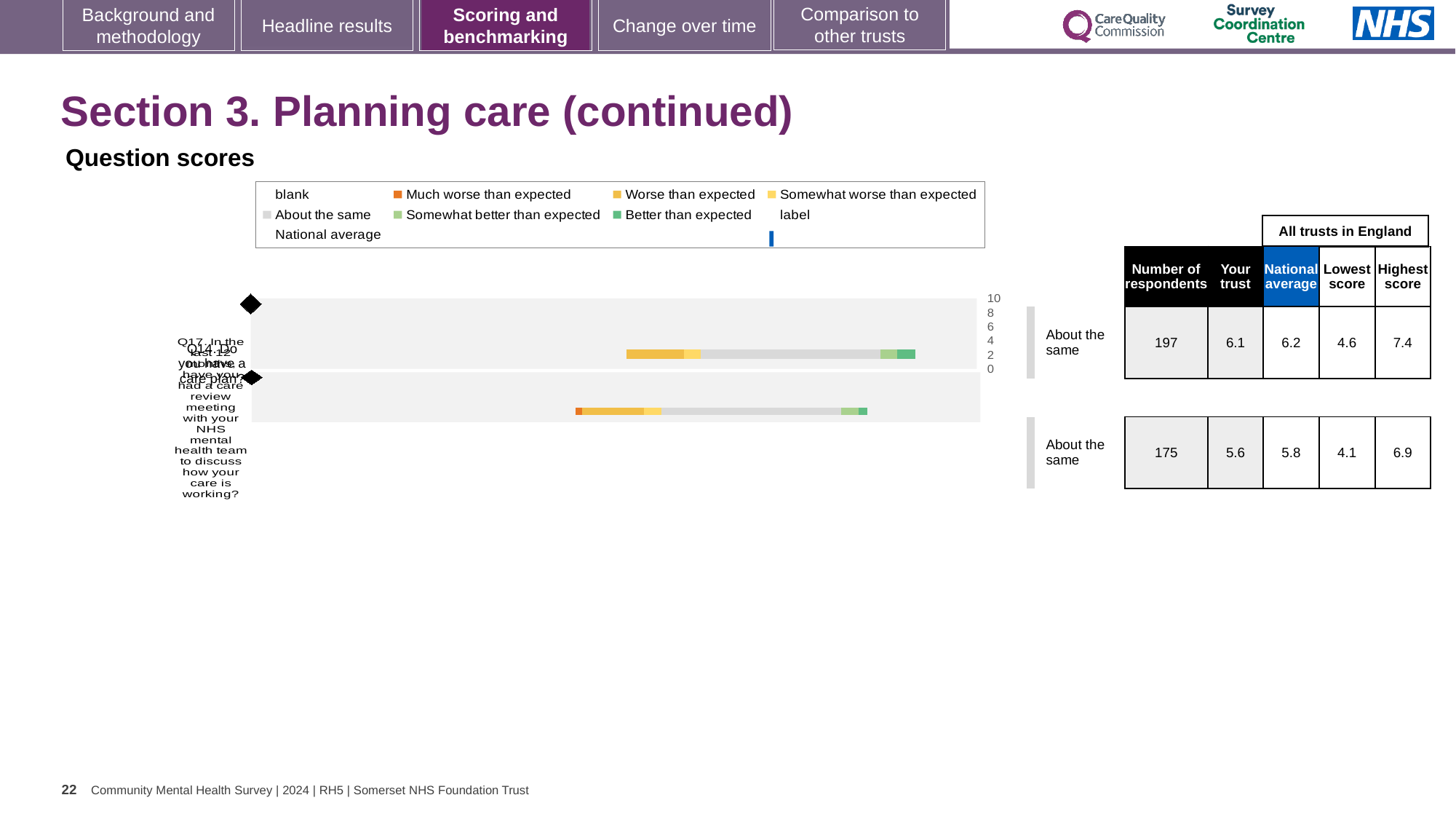
In the top row of the table, what is the difference between the highest score and the lowest score? 2.8 In the table next to the chart, what is the national average in the top row? 6.2 What benchmark category is shown beside both rows of the chart? About the same What is the difference in the number of respondents between the top row and the bottom row of the table? 22 What is the highest value shown on the chart's axis? 10 In the table next to the chart, what is the number of respondents in the top row? 197 In the bottom row of the table, which is larger: the 'Your trust' score or the national average? National average How many questions (bars) are plotted in the chart? 2 In the table next to the chart, what is the 'Your trust' score in the top row? 6.1 What kind of chart is shown on the slide? Bar chart In the table next to the chart, what is the lowest score in the bottom row? 4.1 In the table next to the chart, what is the highest score in the bottom row? 6.9